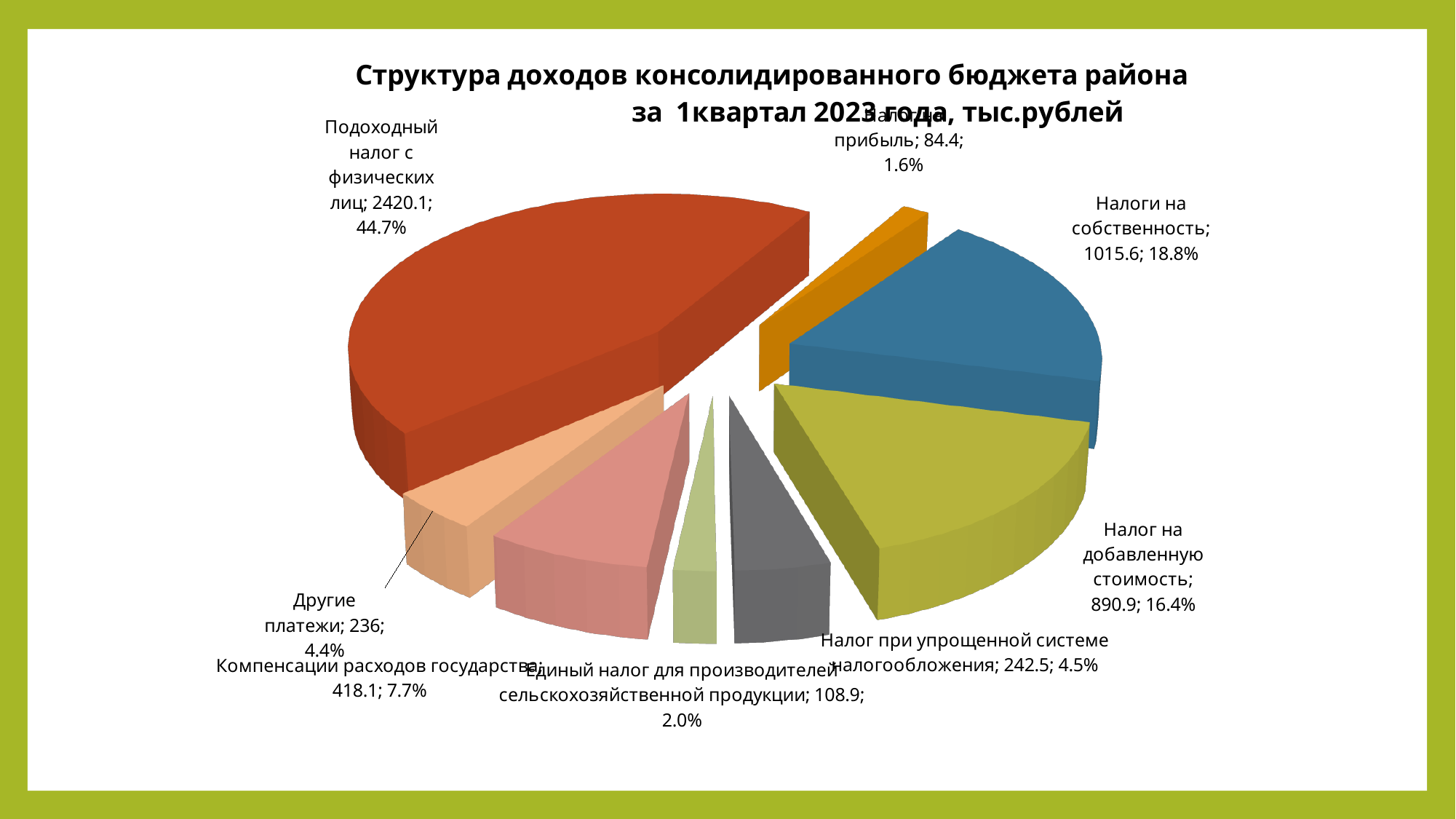
What share of the pie does Другие платежи represent? 4.4% How many slices does the pie chart have? 8 What is the value for Подоходный налог с физических лиц? 2420.1 What is the value for Компенсации расходов государства? 418.1 Which category has the smallest share of the pie? Налог на прибыль What is the value for Единый налог для производителей сельскохозяйственной продукции? 108.9 What kind of chart is shown on the slide? Pie chart What is the value for Налоги на собственность? 1015.6 What share of the pie does Налог на добавленную стоимость represent? 16.4% Which is larger, the value for Налог при упрощенной системе налогообложения or the value for Другие платежи? Налог при упрощенной системе налогообложения Which category has the largest share of the pie? Подоходный налог с физических лиц What is the difference between the values for Подоходный налог с физических лиц and Налоги на собственность? 1404.5